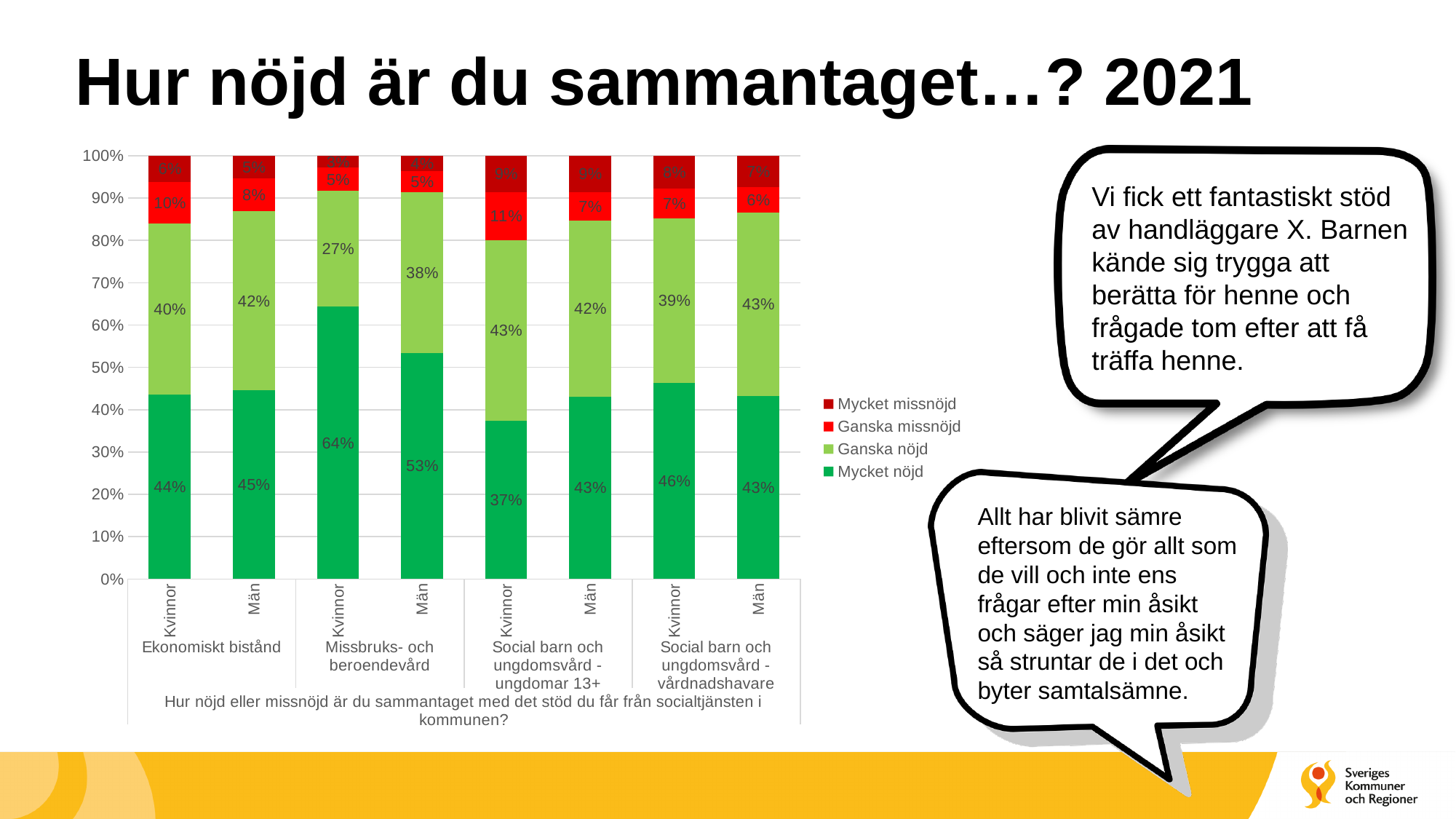
What is the Ganska missnöjd share for Män in Ekonomiskt bistånd? 8% What is the combined share of Mycket nöjd and Ganska nöjd for Kvinnor in Missbruks- och beroendevård? 91% How many bars are shown in the chart? 8 Which has a larger Ganska missnöjd share: Kvinnor in Ekonomiskt bistånd or Kvinnor in Social barn och ungdomsvård - ungdomar 13+? Kvinnor in Social barn och ungdomsvård - ungdomar 13+ What kind of chart is shown on the slide? Stacked bar chart What percentage of Kvinnor in Missbruks- och beroendevård answered Mycket nöjd? 64% What percentage of Män in Missbruks- och beroendevård answered Ganska nöjd? 38% What is the Ganska nöjd share for Kvinnor in Social barn och ungdomsvård - vårdnadshavare? 39% How many percentage points higher is the Mycket nöjd share for Kvinnor than for Män in Missbruks- och beroendevård? 11 percentage points How many series does the legend list? 4 Which bar has the lowest Mycket nöjd share? Kvinnor, Social barn och ungdomsvård - ungdomar 13+ Which bar has the highest Mycket nöjd share? Kvinnor, Missbruks- och beroendevård